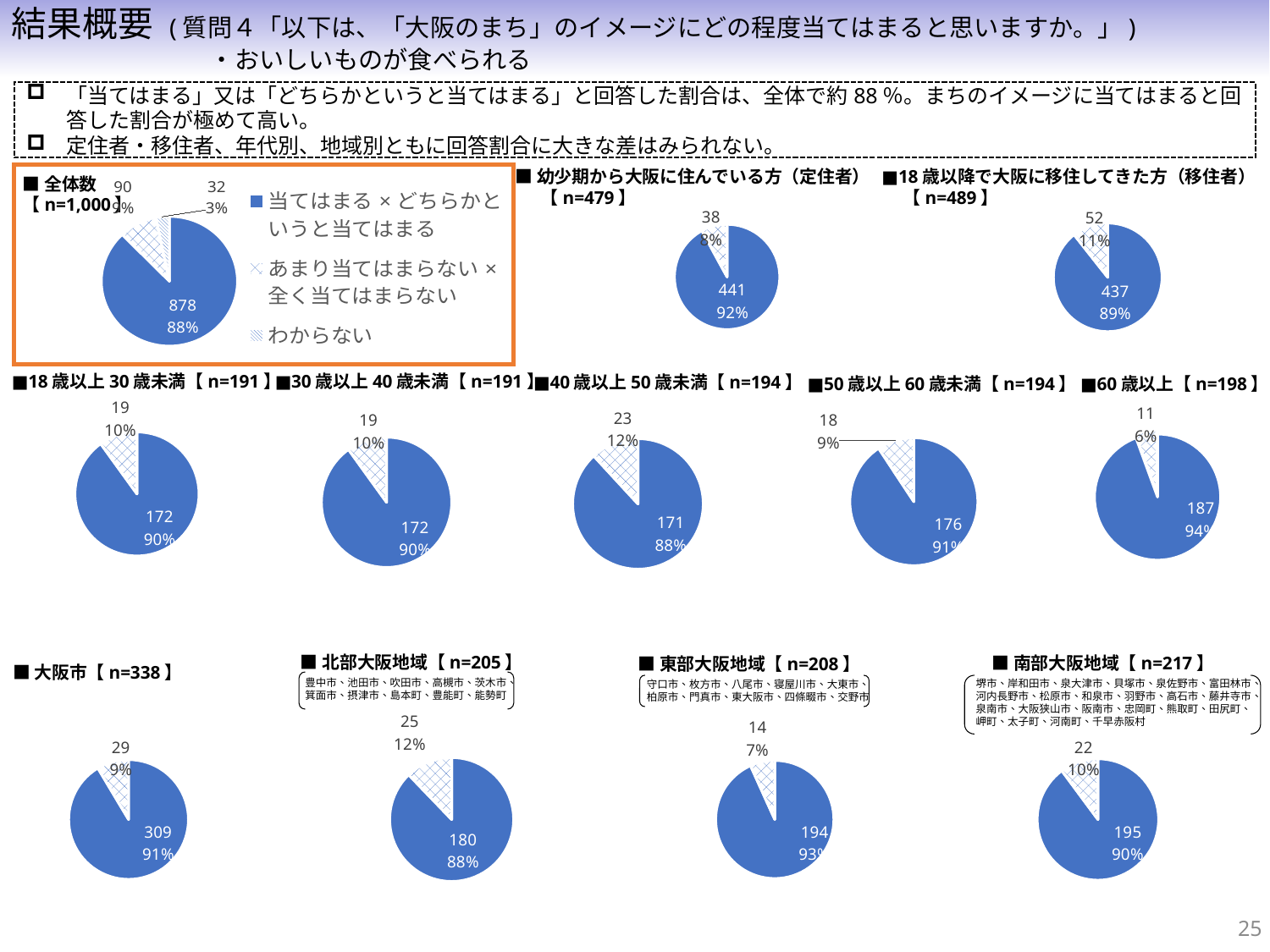
In the 幼少期から大阪に住んでいる方（定住者）【n=479】 chart, what is the count for the largest slice? 441 How many entries does the legend of the 全体数【n=1,000】 chart list? 3 In the 60歳以上【n=198】 chart, what is the count for the largest slice? 187 Which is larger: the largest slice percentage in the 東部大阪地域【n=208】 chart or in the 北部大阪地域【n=205】 chart? 東部大阪地域【n=208】 In the 全体数【n=1,000】 chart, what is the count for 当てはまる × どちらかというと当てはまる? 878 In the 大阪市【n=338】 chart, what is the count for the smaller slice? 29 In the 18歳以降で大阪に移住してきた方（移住者）【n=489】 chart, what percentage is shown for the smaller slice? 11% In the 南部大阪地域【n=217】 chart, what percentage is shown for the largest slice? 90% In the 全体数【n=1,000】 chart, what percentage share does the 当てはまる × どちらかというと当てはまる slice have? 88% What type of chart is used for the 全体数【n=1,000】 chart? pie chart In the 50歳以上60歳未満【n=194】 chart, what is the count for the largest slice? 176 In the 40歳以上50歳未満【n=194】 chart, what is the difference between the two slice counts (171 and 23)? 148